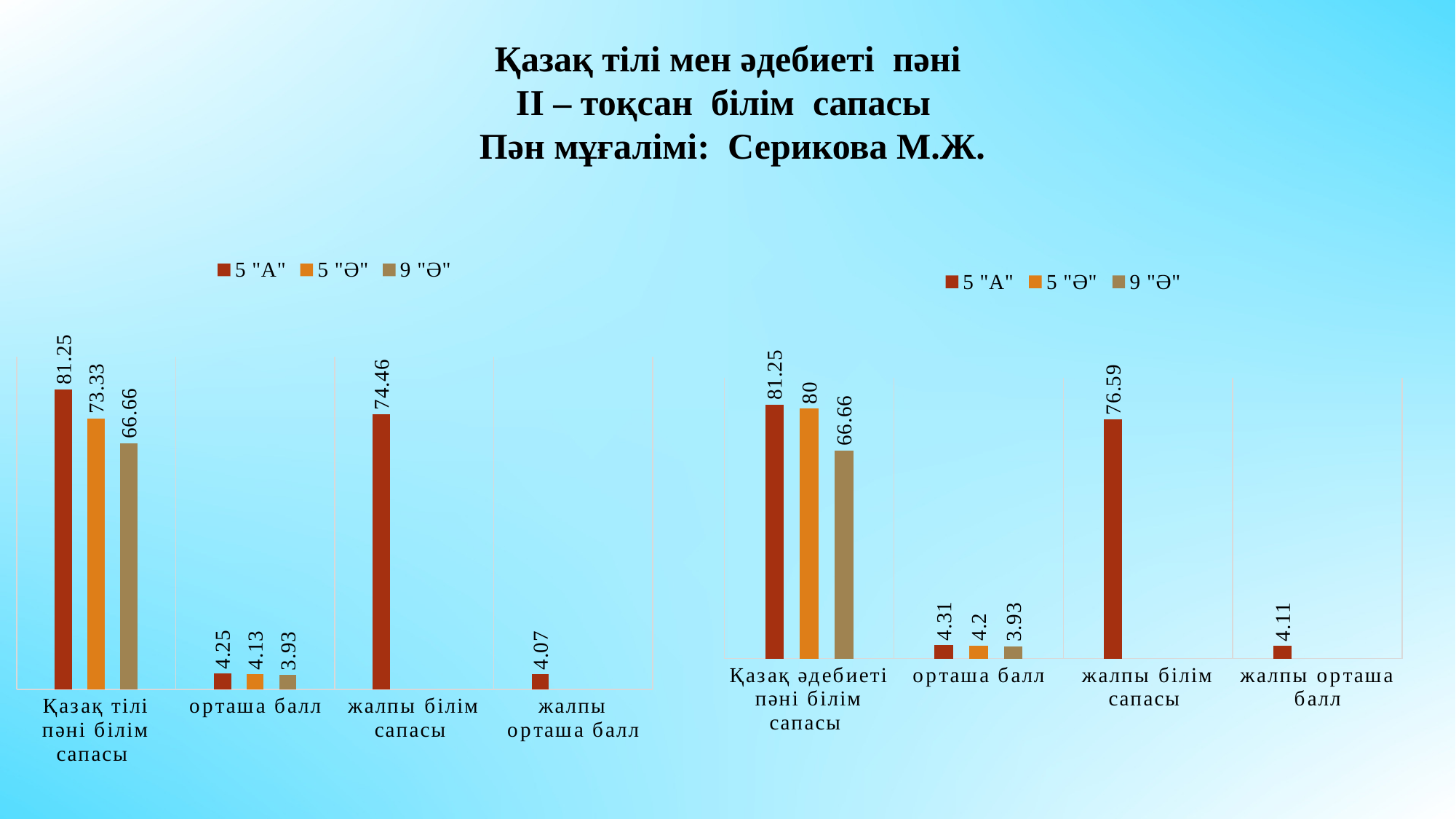
On the right chart, what is the value for 5 "А" in the category жалпы орташа балл? 4.11 On the left chart, what is the value for 5 "А" in the category жалпы білім сапасы? 74.46 On the left chart, what is the difference between the 5 "А" and 9 "Ә" values in the category Қазақ тілі пәні білім сапасы? 14.59 How many categories are shown on the x axis of the right chart? 4 On the right chart, what is the value for 5 "Ә" in the category Қазақ әдебиеті пәні білім сапасы? 80 How many series does the legend of the left chart list? 3 On the left chart, which series has the highest value in the category Қазақ тілі пәні білім сапасы? 5 "А" On the right chart, what is the difference between the 5 "А" and 5 "Ә" values in the category Қазақ әдебиеті пәні білім сапасы? 1.25 On the right chart, which series has the lowest value in the category орташа балл? 9 "Ә" What type of chart is the left chart? bar chart Which is larger: the 5 "А" value for жалпы білім сапасы on the left chart or on the right chart? right chart (76.59) On the left chart, what is the value for 5 "Ә" in the category Қазақ тілі пәні білім сапасы? 73.33